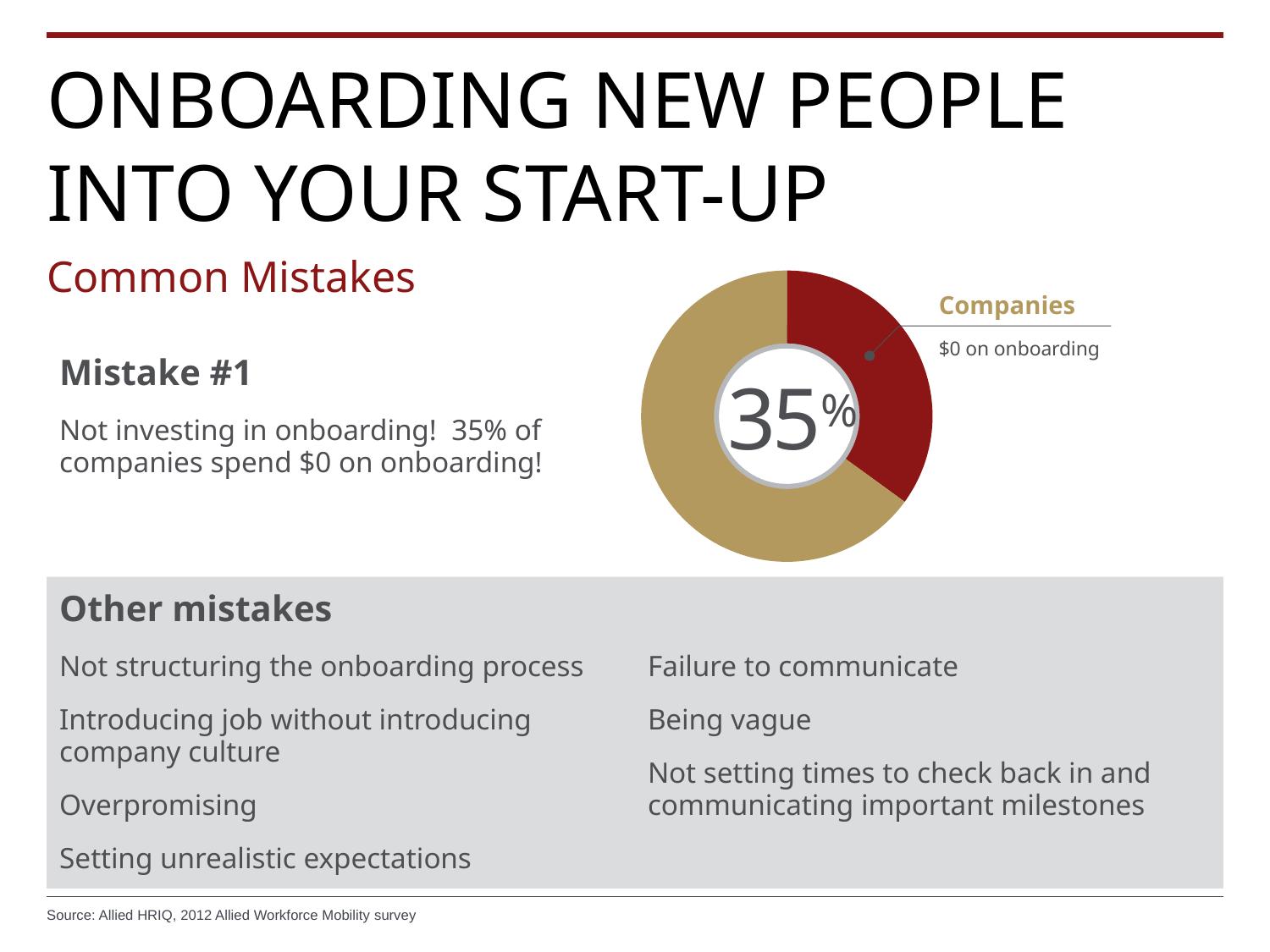
Which slice of the donut chart is larger, the red one or the gold one? The gold one How many slices does the donut chart have? 2 What is the heading label shown next to the donut chart? Companies What percentage is shown in the centre of the donut chart? 35% What kind of chart is shown on the slide? Pie chart (donut) What does the red slice of the donut chart represent, according to its callout label? $0 on onboarding What share of companies does the red slice of the donut chart represent? 35% What share of the donut chart is taken up by the gold slice? 65% Is the share represented by the red slice of the donut chart greater or less than 50%? less